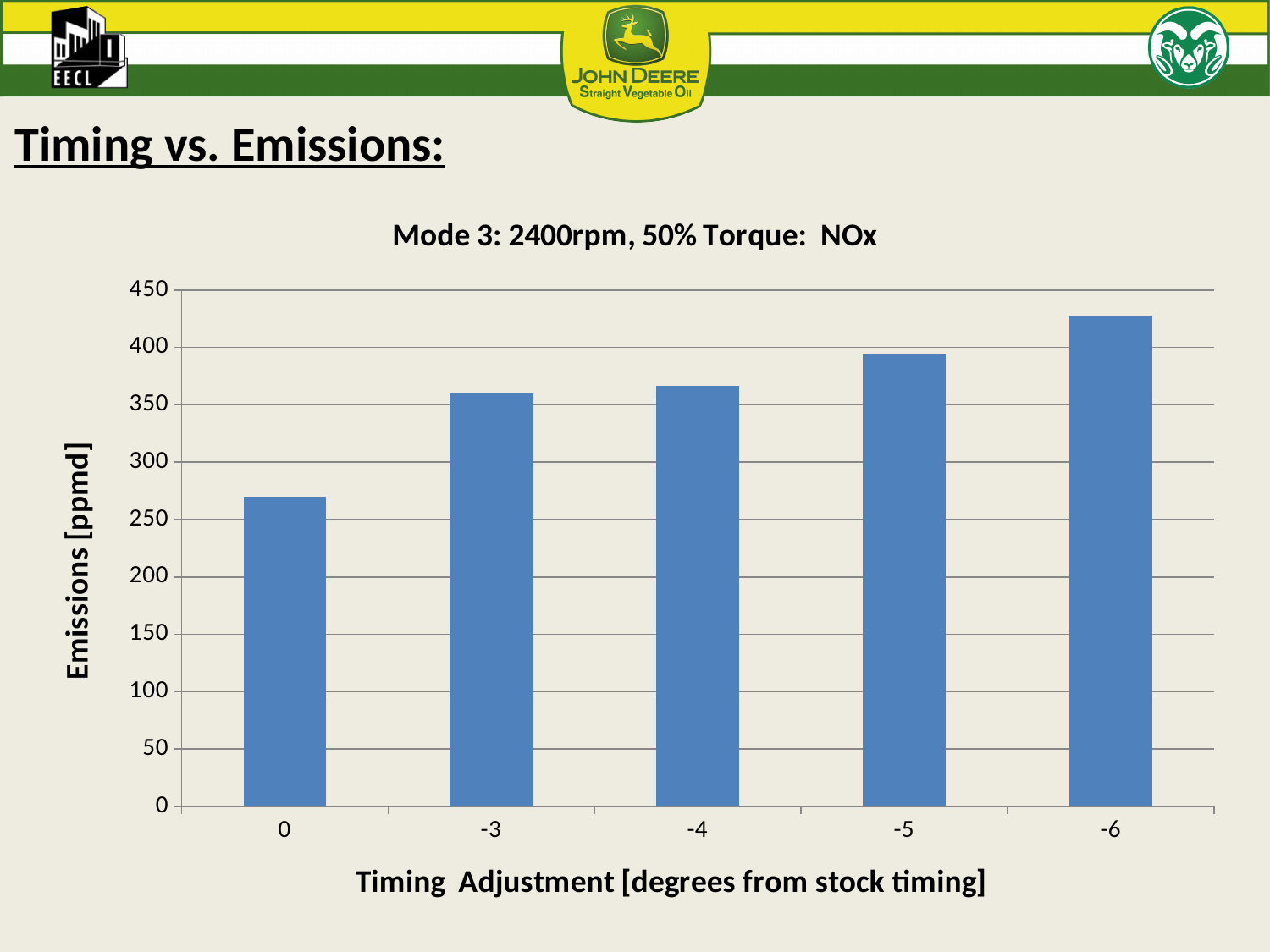
What is the label of the y axis? Emissions [ppmd] What is the title of the chart? Mode 3: 2400rpm, 50% Torque: NOx Which timing adjustment has the highest NOx emissions? -6 Is the value for timing adjustment 0 greater or less than 300? less Which timing adjustment has the lowest NOx emissions? 0 Which has higher emissions, timing adjustment -5 or -6? -6 What kind of chart is shown on the slide? bar chart Do the emissions rise or fall as the timing adjustment goes from 0 to -6 along the x axis? rise Is the value for timing adjustment -6 greater or less than 400? greater Is the value for timing adjustment -3 greater or less than 300? greater How many timing adjustment categories are plotted? 5